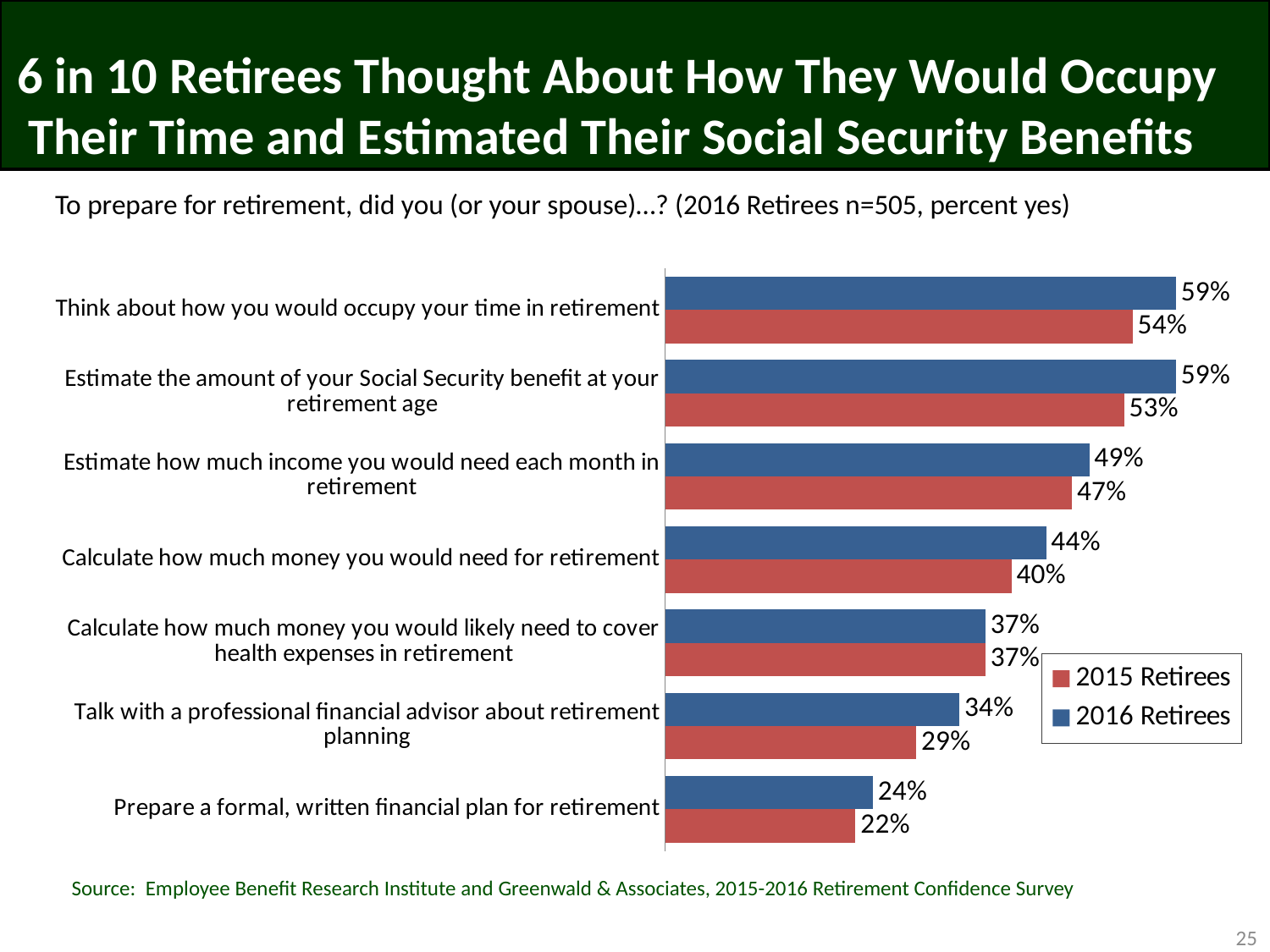
What percentage of 2016 Retirees said they thought about how they would occupy their time in retirement? 59% What kind of chart is shown on the slide? Bar chart What percentage of 2015 Retirees said they talked with a professional financial advisor about retirement planning? 29% Which colour represents 2016 Retirees in the chart? Blue What percentage of 2015 Retirees said they estimated the amount of their Social Security benefit at their retirement age? 53% Which activity has the lowest percentage among 2015 Retirees? Prepare a formal, written financial plan for retirement What is the difference between 2016 Retirees and 2015 Retirees for 'Think about how you would occupy your time in retirement'? 5% Which is larger for 'Calculate how much money you would need for retirement': the 2016 Retirees value or the 2015 Retirees value? 2016 Retirees What percentage of 2016 Retirees said they prepared a formal, written financial plan for retirement? 24% What is the difference between 2016 Retirees and 2015 Retirees for 'Talk with a professional financial advisor about retirement planning'? 5% How many series does the legend list? 2 How many activities (categories) are shown in the chart? 7